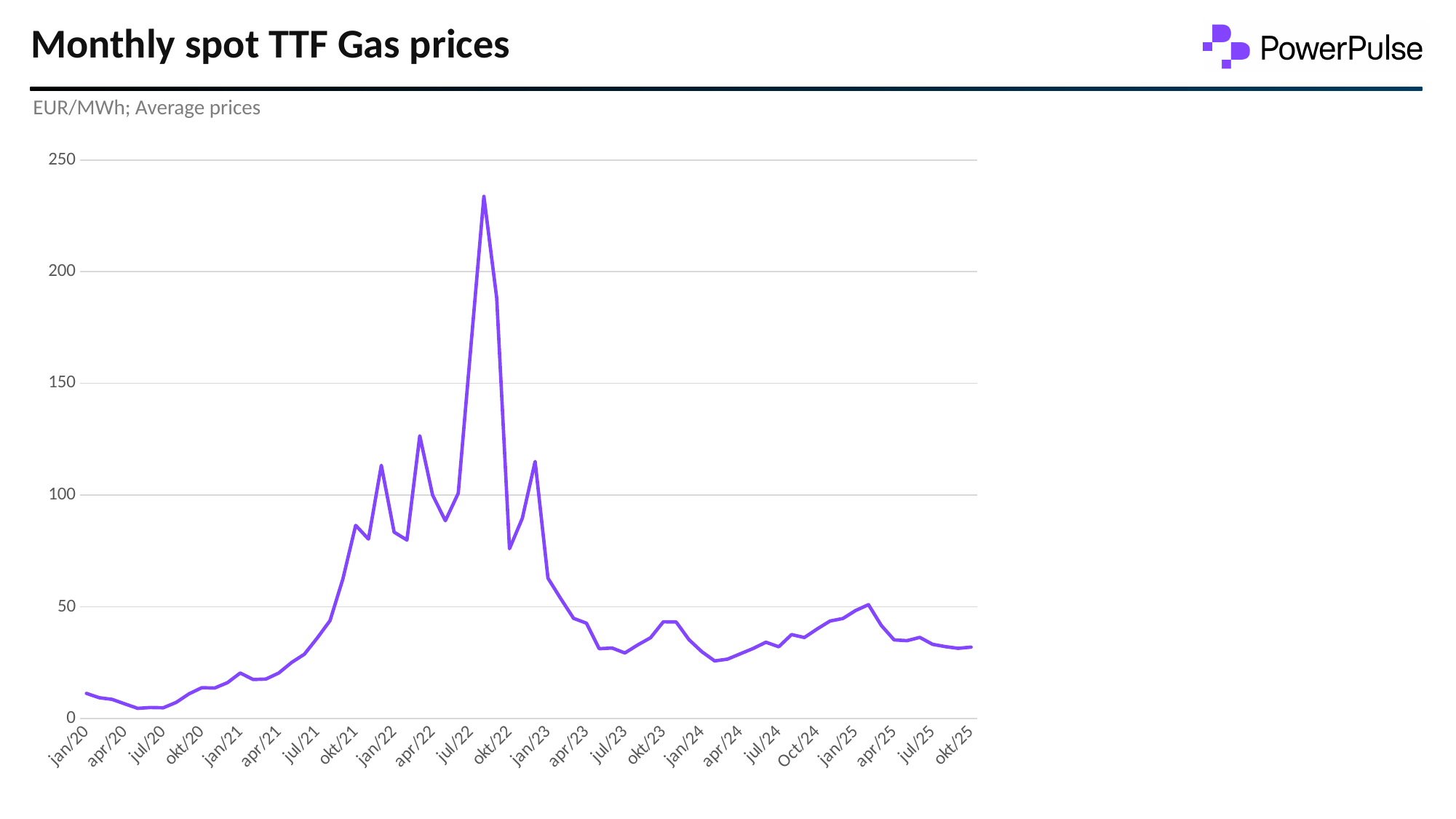
How many labels are shown on the x axis? 24 Is the value for jan/20 greater or less than 50? less What kind of chart is shown on the slide? line chart Is the value for okt/22 greater or less than 100? less Is the value for okt/21 greater or less than 50? greater Do the values rise or fall from jan/21 to okt/21? rise What unit are the prices shown in, according to the subtitle? EUR/MWh Do the values rise or fall from jan/23 to jul/23? fall What is the title of the chart? Monthly spot TTF Gas prices In which year does the line reach its highest point? 2022